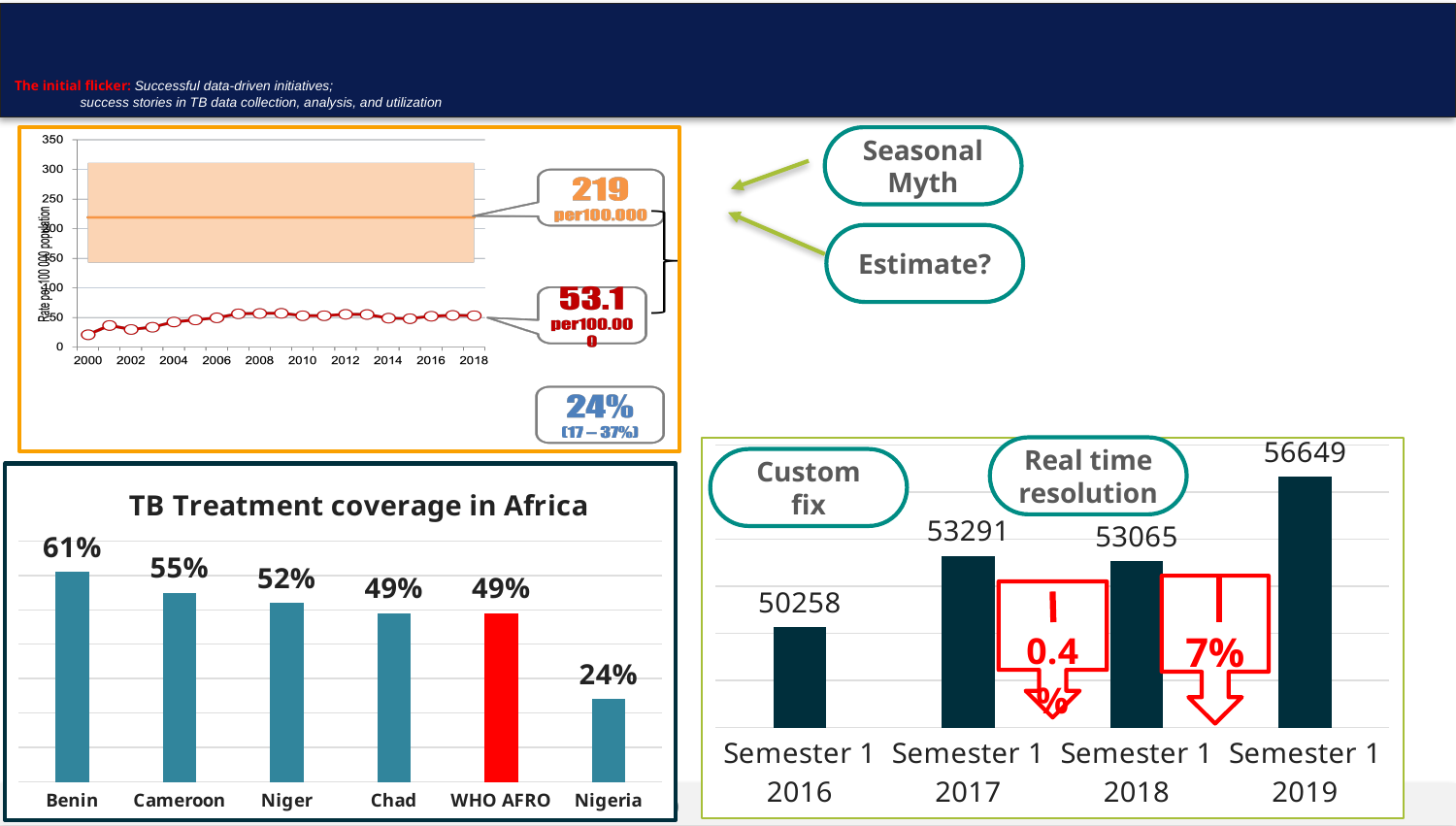
In the 'TB Treatment coverage in Africa' chart, which category's bar is coloured red? WHO AFRO In the 'TB Treatment coverage in Africa' chart, which category has the lowest value? Nigeria In the 'TB Treatment coverage in Africa' chart, what is the difference between the values for Benin and Nigeria? 37% What kind of chart is the top-left chart showing rates per 100,000 population from 2000 to 2018? line chart In the 'TB Treatment coverage in Africa' chart, what is the value for Benin? 61% In the bottom-right bar chart, what is the value for Semester 1 2019? 56649 How many categories are shown in the 'TB Treatment coverage in Africa' chart? 6 In the bottom-right bar chart, which semester has the lowest value? Semester 1 2016 In the 'TB Treatment coverage in Africa' chart, which country has the highest treatment coverage? Benin In the 'TB Treatment coverage in Africa' chart, what is the value for Nigeria? 24% In the 'TB Treatment coverage in Africa' chart, which is larger, the value for Cameroon or the value for Niger? Cameroon In the bottom-right bar chart, what is the difference between the values for Semester 1 2017 and Semester 1 2016? 3033